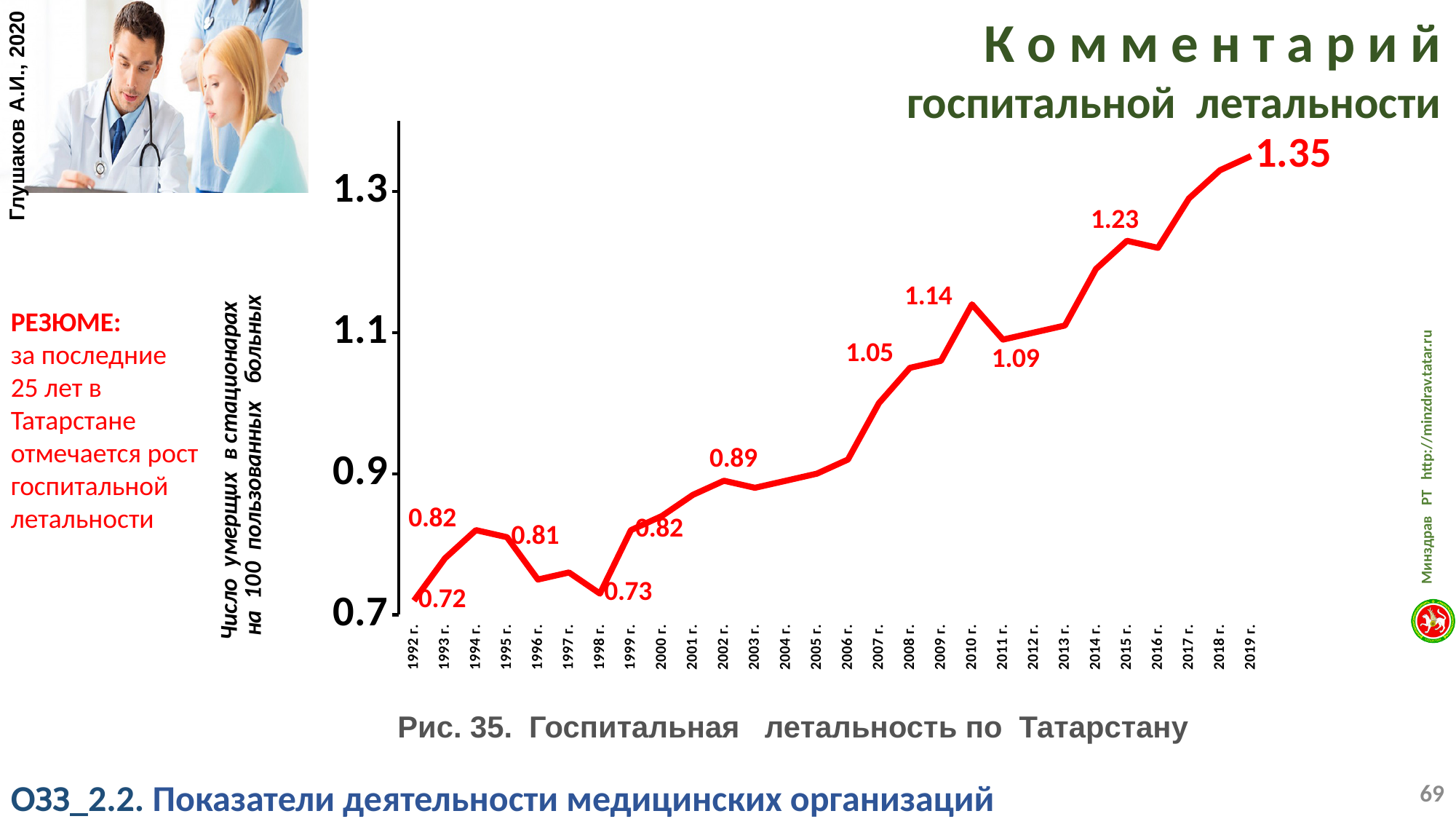
What value is labelled for 2010 г.? 1.14 What value is labelled for 2015 г.? 1.23 What is the difference between the values for 2019 г. and 1992 г.? 0.63 What kind of chart is shown on the slide? line chart Which year has the lowest hospital mortality value? 1992 г. What is the value plotted for 1992 г.? 0.72 Which year has the larger value, 2010 г. or 2011 г.? 2010 г. Which year has the highest hospital mortality value? 2019 г. Does hospital mortality generally rise or fall from 1992 to 2019? rise How many years are shown on the x axis? 28 What is the hospital mortality value for 2019 г.? 1.35 Is the value for 2000 г. greater or less than 0.9? less